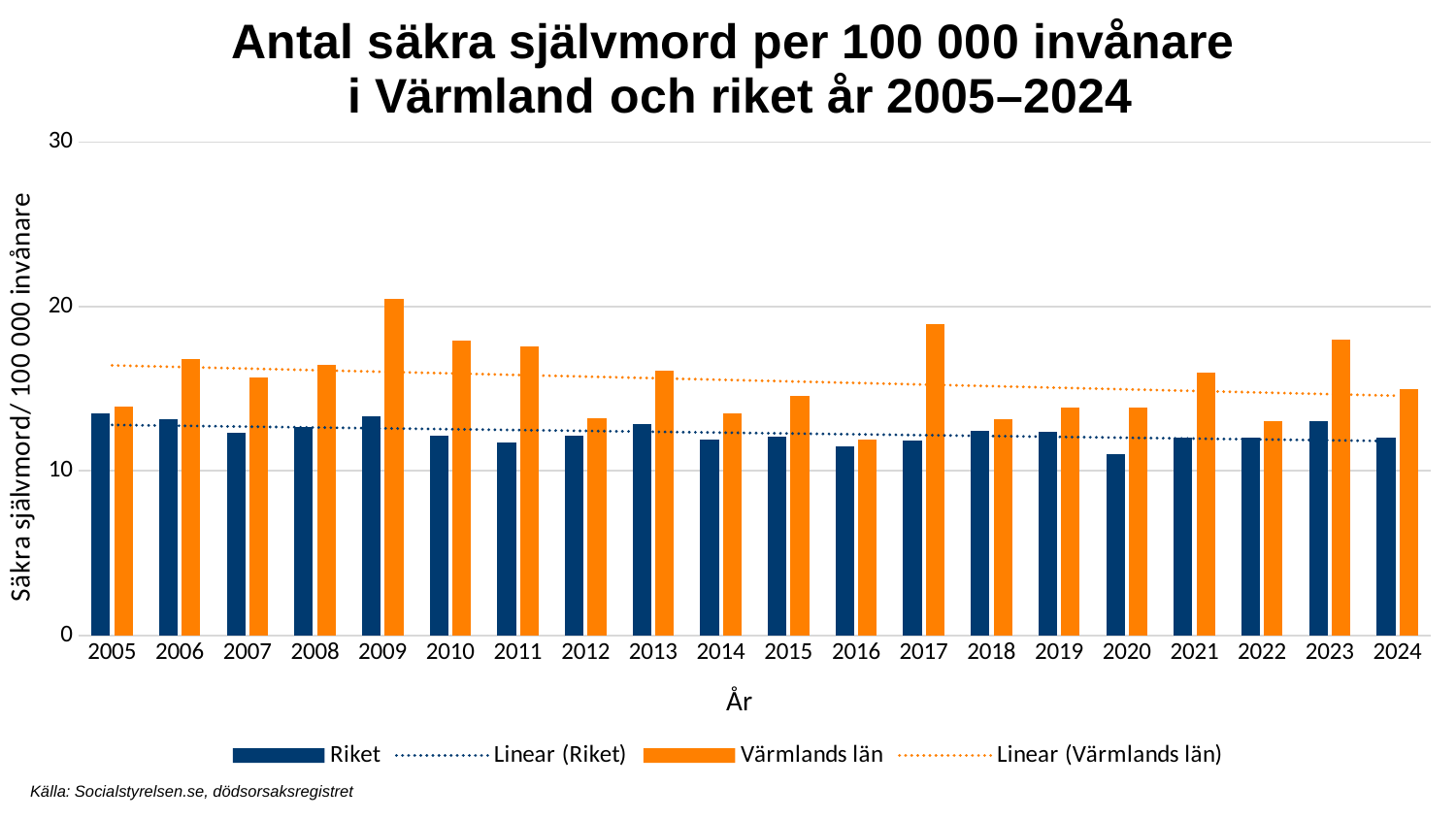
In which year is the value for Riket lowest? 2020 What is the title of the x axis of the chart? År Is the value for Värmlands län in 2009 greater or less than 20? greater How many entries does the chart's legend list? 4 Does the dotted trend line for Värmlands län rise or fall from 2005 to 2024? fall In which year is the value for Värmlands län lowest? 2016 Is the value for Värmlands län in 2017 greater or less than 20? less Is the value for Riket in 2020 greater or less than 10? greater In which year is the value for Värmlands län highest? 2009 In 2009, which is larger: the value for Riket or for Värmlands län? Värmlands län How many years are shown on the x axis of the chart? 20 What kind of chart is shown on the slide? bar chart